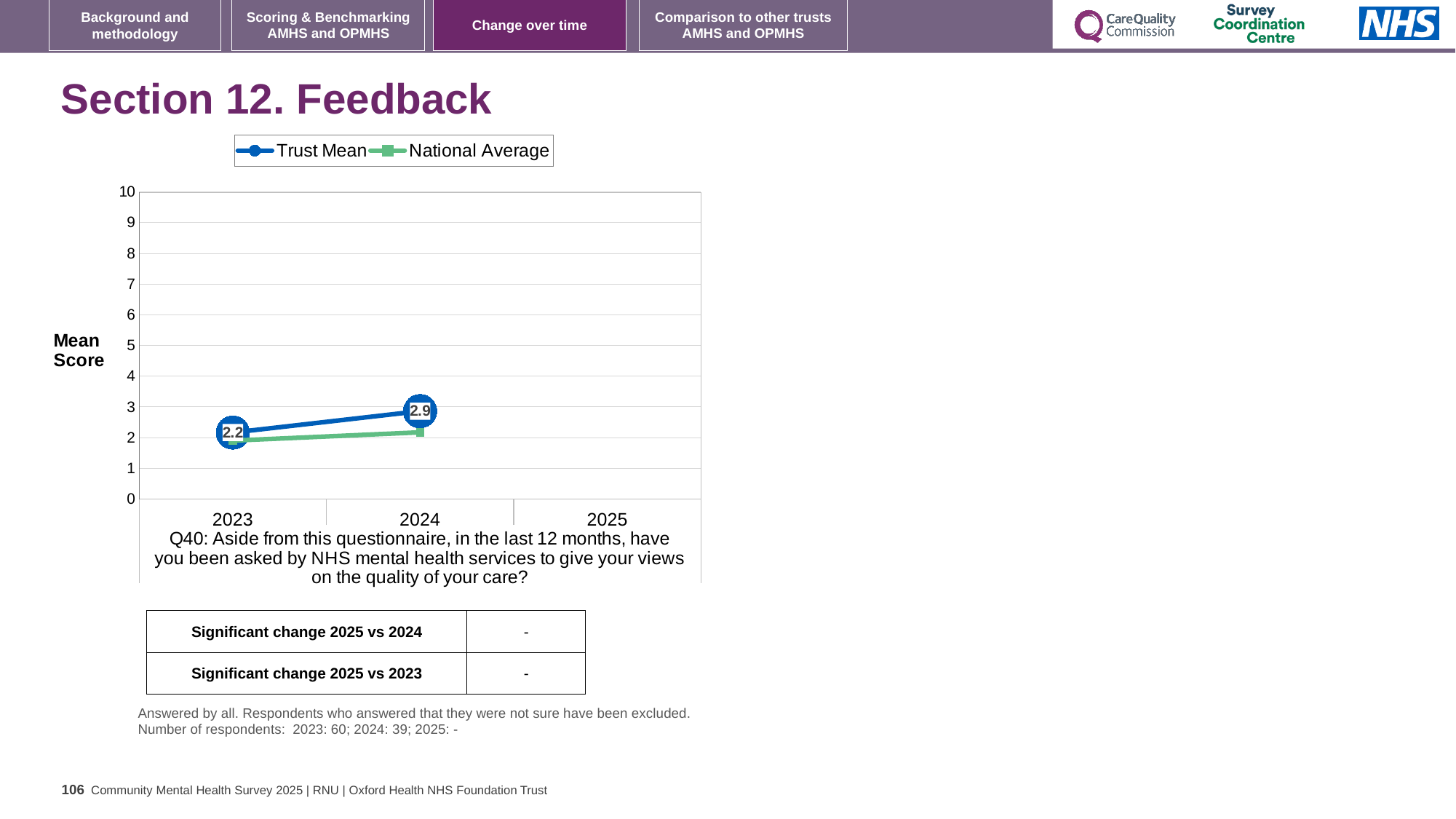
What is the difference between the Trust Mean in 2024 and in 2023? 0.7 In 2024, which series is higher, Trust Mean or National Average? Trust Mean Does the Trust Mean rise or fall from 2023 to 2024? rise Which year has the higher Trust Mean, 2023 or 2024? 2024 Is the National Average value for 2024 greater or less than 4? less How many series does the legend list? 2 Is the National Average value for 2023 greater or less than 3? less What kind of chart is shown on the slide? line chart What is the Trust Mean value for 2023? 2.2 What is the label on the y axis of the chart? Mean Score How many years are shown on the x axis of the chart? 3 What is the Trust Mean value for 2024? 2.9